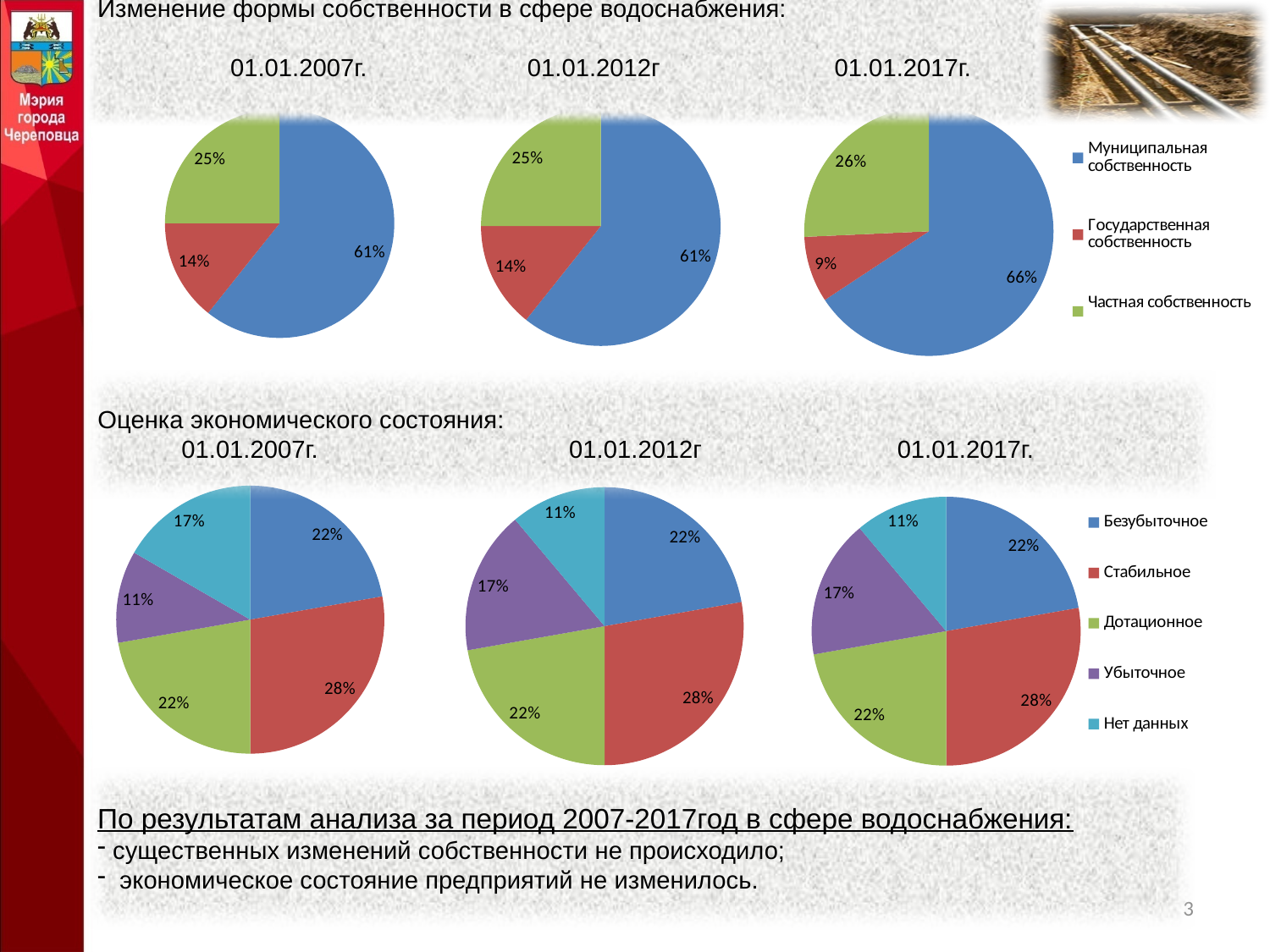
In the economic-condition pie chart for 01.01.2012, which category has the largest share? Стабильное How many categories does the legend of the economic-condition pie charts list? 5 By how many percentage points did the municipal property share change between the 01.01.2012 and 01.01.2017 ownership-form pie charts? 5 percentage points In the economic-condition pie chart for 01.01.2007, which is larger: 'Убыточное' or 'Нет данных'? Нет данных How many series does the legend of the ownership-form pie charts list? 3 In the ownership-form pie chart for 01.01.2017, what share is municipal property (Муниципальная собственность)? 66% In the ownership-form pie chart for 01.01.2007, what share is state property (Государственная собственность)? 14% In the economic-condition pie chart for 01.01.2017, what share is 'Нет данных'? 11% In the ownership-form pie chart for 01.01.2017, which category has the smallest share? Государственная собственность What type of charts are shown on the slide? Pie charts In the ownership-form pie chart for 01.01.2012, which category has the largest share? Муниципальная собственность In the economic-condition pie chart for 01.01.2007, what share is 'Стабильное'? 28%